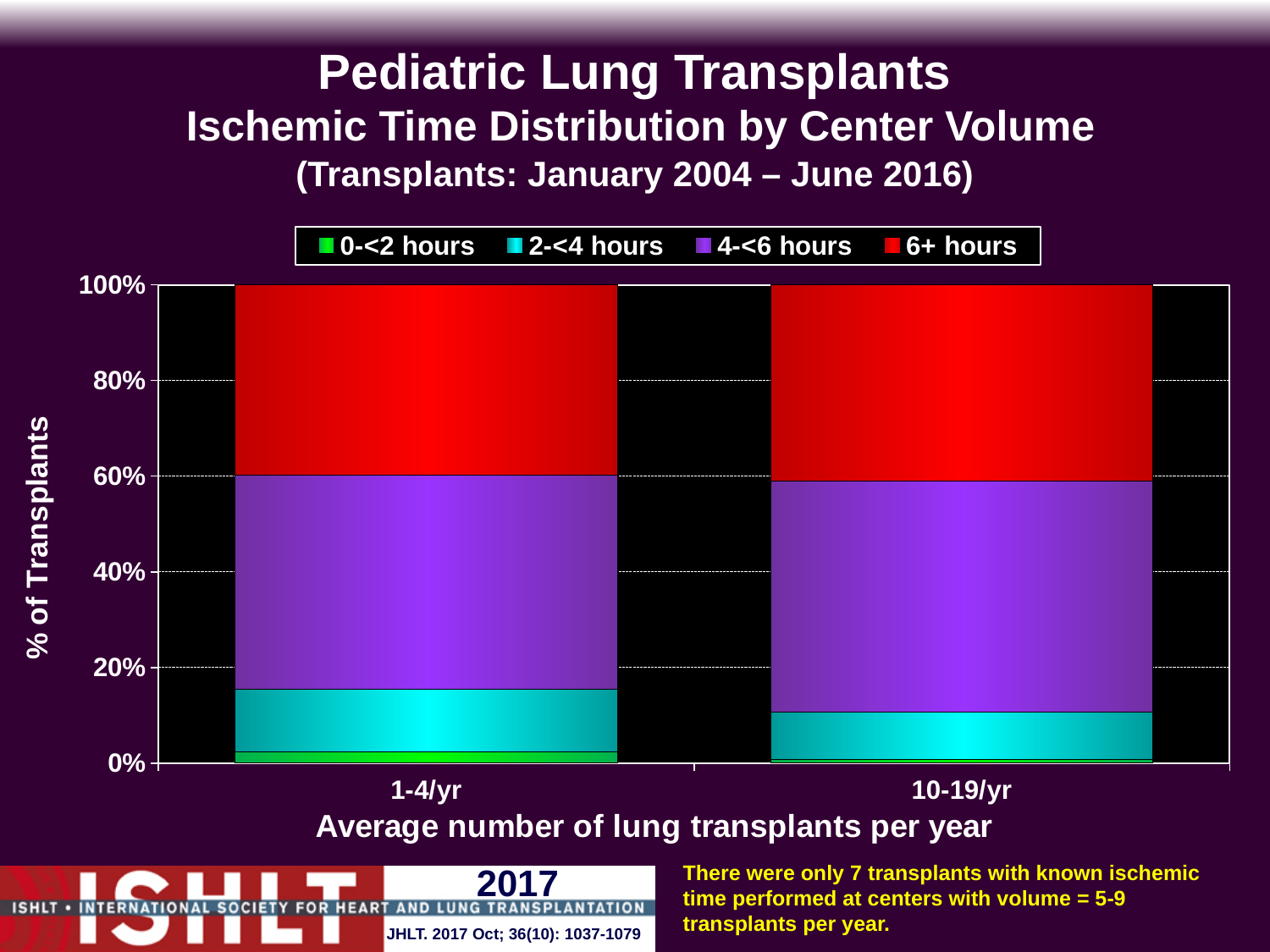
What kind of chart is shown on the slide? Stacked bar chart How many series does the legend list? 4 Which ischemic time category has the smallest share in the 10-19/yr bar? 0-<2 hours Which legend entry is shown in red? 6+ hours What is the label of the y axis? % of Transplants How many center volume categories are shown on the x axis? 2 Which center volume category has the larger 2-<4 hours share, 1-4/yr or 10-19/yr? 1-4/yr Is the 4-<6 hours share for 10-19/yr greater or less than 20%? greater Is the 6+ hours share for 1-4/yr greater or less than 20%? greater Is the 0-<2 hours share for 1-4/yr greater or less than 20%? less What is the total height of the stacked bar for 1-4/yr? 100%